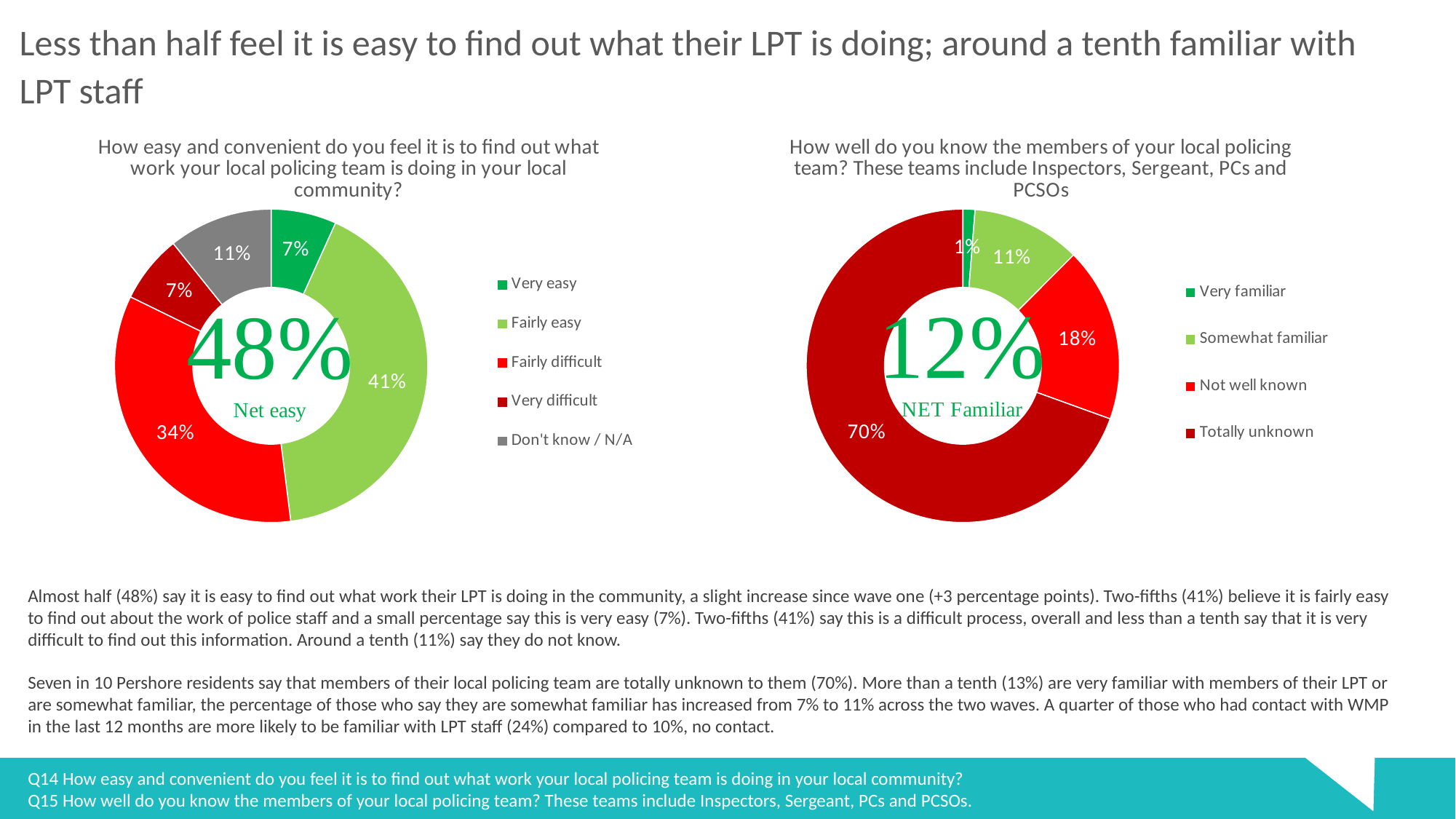
How many categories does the legend of the right chart (How well do you know...) list? 4 In the right chart (How well do you know...), which is larger: 'Somewhat familiar' or 'Not well known'? Not well known What type of chart is used on the left of the slide (How easy and convenient...)? Donut (pie) chart In the right chart (How well do you know the members of your local policing team), what percentage said 'Totally unknown'? 70% In the left chart (How easy and convenient...), what is the 'Net easy' figure shown in the centre of the donut? 48% In the left chart (How easy and convenient...), what is the difference between 'Fairly easy' and 'Fairly difficult'? 7 percentage points In the left chart (How easy and convenient...), what percentage answered 'Don't know / N/A'? 11% In the right chart (How well do you know...), which category has the smallest share? Very familiar In the right chart (How well do you know...), what percentage said 'Not well known'? 18% In the left chart (How easy and convenient do you feel it is to find out what work your local policing team is doing), what percentage said 'Fairly easy'? 41% In the left chart (How easy and convenient...), which category has the largest share? Fairly easy In the left chart (How easy and convenient...), what percentage said 'Fairly difficult'? 34%